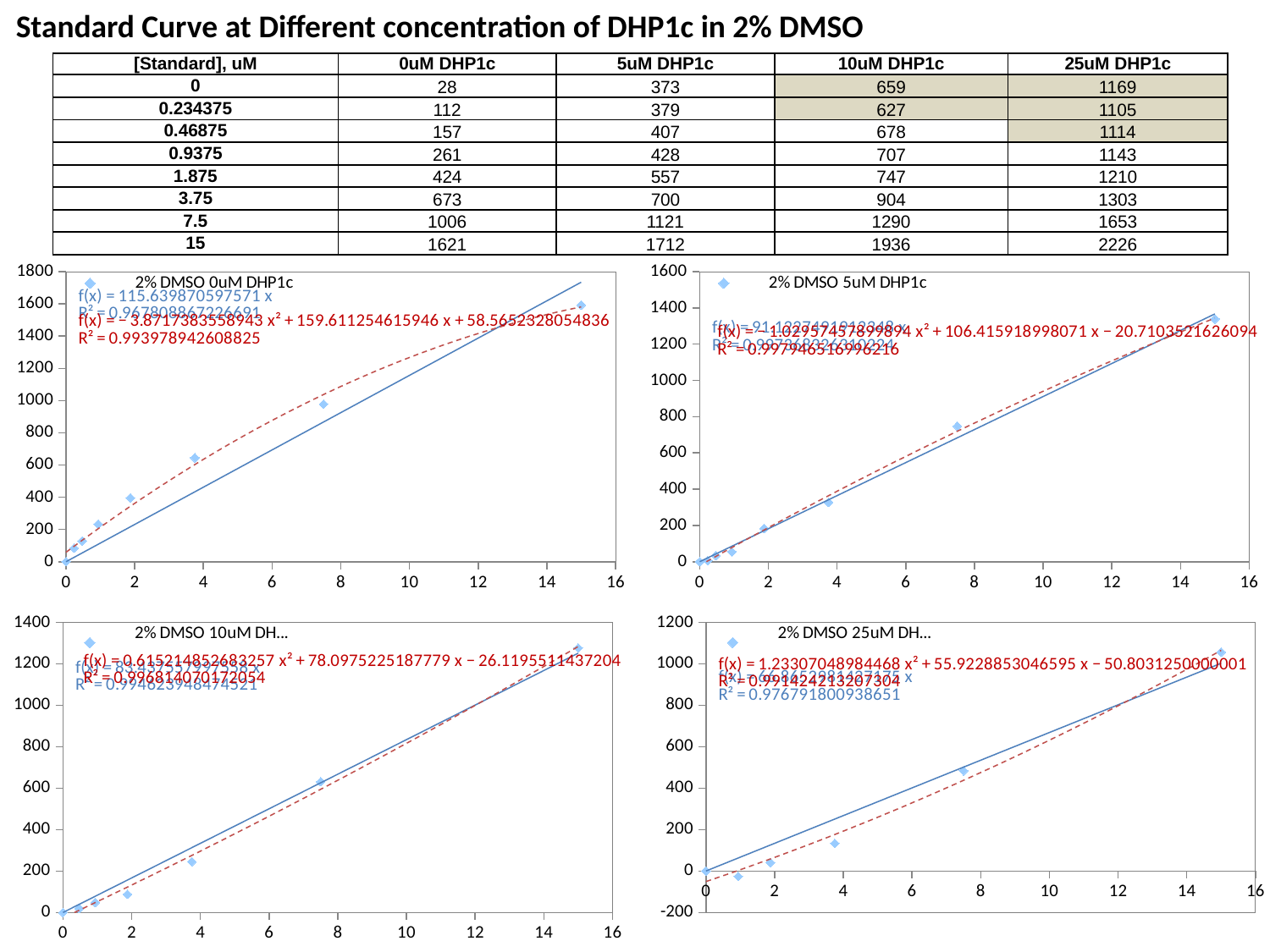
In the top-left chart '2% DMSO 0uM DHP1c', what R² value is printed in red for the polynomial trendline? 0.993978942608825 In the top-left chart '2% DMSO 0uM DHP1c', is the value of the point at x = 15 greater or less than 1400? greater What is the minimum value shown on the y axis of the bottom-right chart '2% DMSO 25uM DH...'? -200 How many data points are plotted in the bottom-right chart '2% DMSO 25uM DH...'? 6 In the top-right chart '2% DMSO 5uM DHP1c', is the value of the point at x = 3.75 greater or less than 400? less In the top-left chart '2% DMSO 0uM DHP1c', do the plotted values rise or fall as the x value increases? rise In the bottom-left chart '2% DMSO 10uM DH...', is the value of the point at x = 15 greater or less than 1000? greater What is the maximum value shown on the y axis of the top-left chart '2% DMSO 0uM DHP1c'? 1800 What kind of chart is the top-left chart titled '2% DMSO 0uM DHP1c'? scatter chart